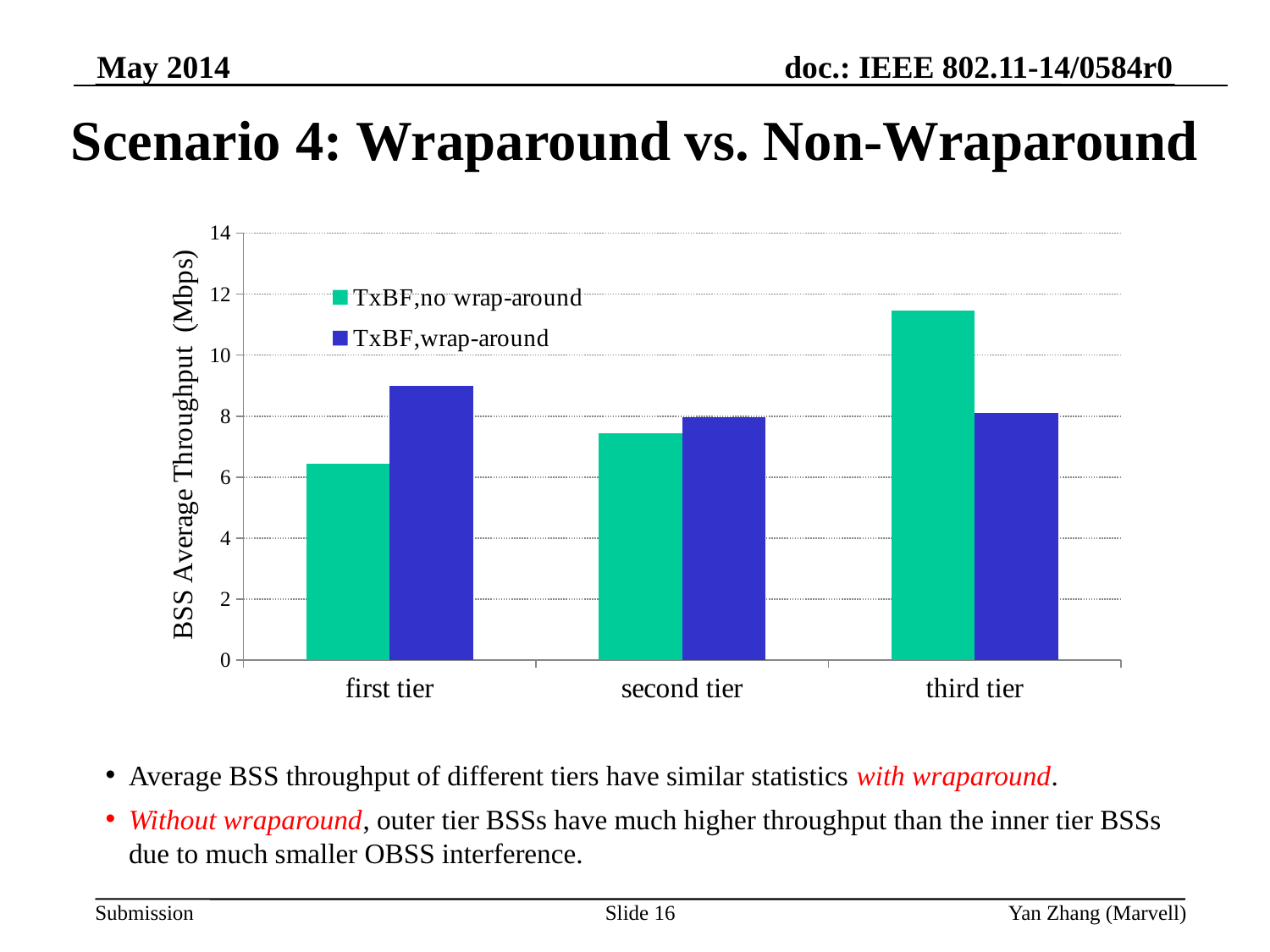
Is the TxBF,no wrap-around value for the third tier greater or less than 10? greater How many series does the chart legend list? 2 How many tier categories are shown on the x axis? 3 Do the TxBF,no wrap-around values rise or fall from first tier to third tier? rise For the third tier, which series has the larger value, TxBF,no wrap-around or TxBF,wrap-around? TxBF,no wrap-around Which tier has the highest value for the TxBF,wrap-around series? first tier Which tier has the lowest value for the TxBF,no wrap-around series? first tier What kind of chart is shown on the slide? bar chart What is the label of the vertical axis? BSS Average Throughput (Mbps) Which tier has the highest value for the TxBF,no wrap-around series? third tier For the first tier, which series has the larger value, TxBF,no wrap-around or TxBF,wrap-around? TxBF,wrap-around Which series is drawn in green? TxBF,no wrap-around